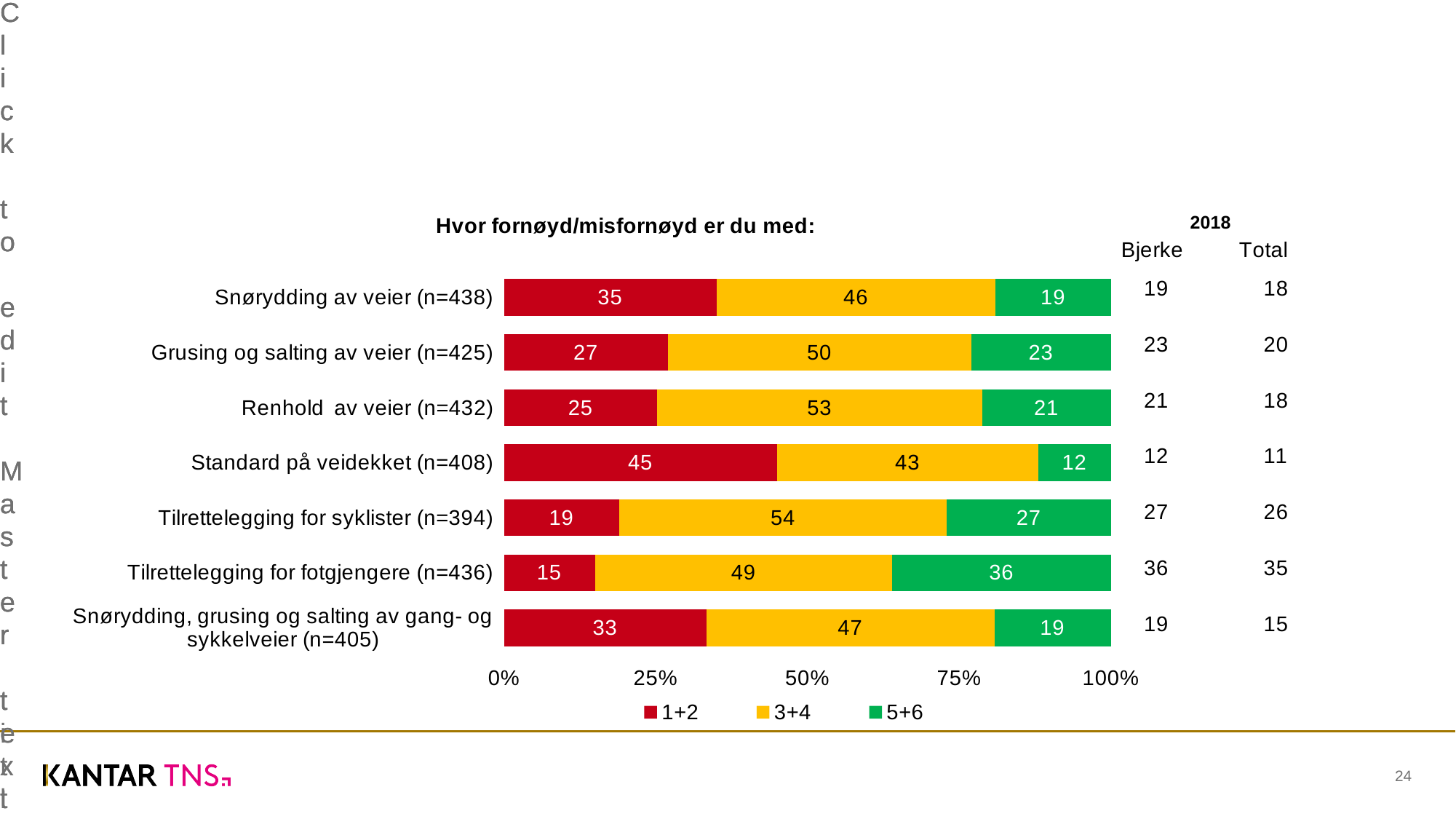
What is the value of the 5+6 series for Tilrettelegging for fotgjengere (n=436)? 36 How many categories are shown in the chart? 7 What is the difference between the 3+4 values for Renhold av veier (n=432) and Snørydding av veier (n=438)? 7 What is the total of the stacked bar for Grusing og salting av veier (n=425)? 100 What kind of chart is shown on the slide? Stacked bar chart Which is larger: the 1+2 value for Snørydding av veier (n=438) or the 1+2 value for Grusing og salting av veier (n=425)? Snørydding av veier (n=438) What is the title of the chart? Hvor fornøyd/misfornøyd er du med: How many series does the legend list? 3 Which category has the lowest value in the 5+6 series? Standard på veidekket (n=408) What is the value of the 1+2 series for Standard på veidekket (n=408)? 45 Which category has the highest value in the 1+2 series? Standard på veidekket (n=408) What is the value of the 3+4 series for Tilrettelegging for syklister (n=394)? 54